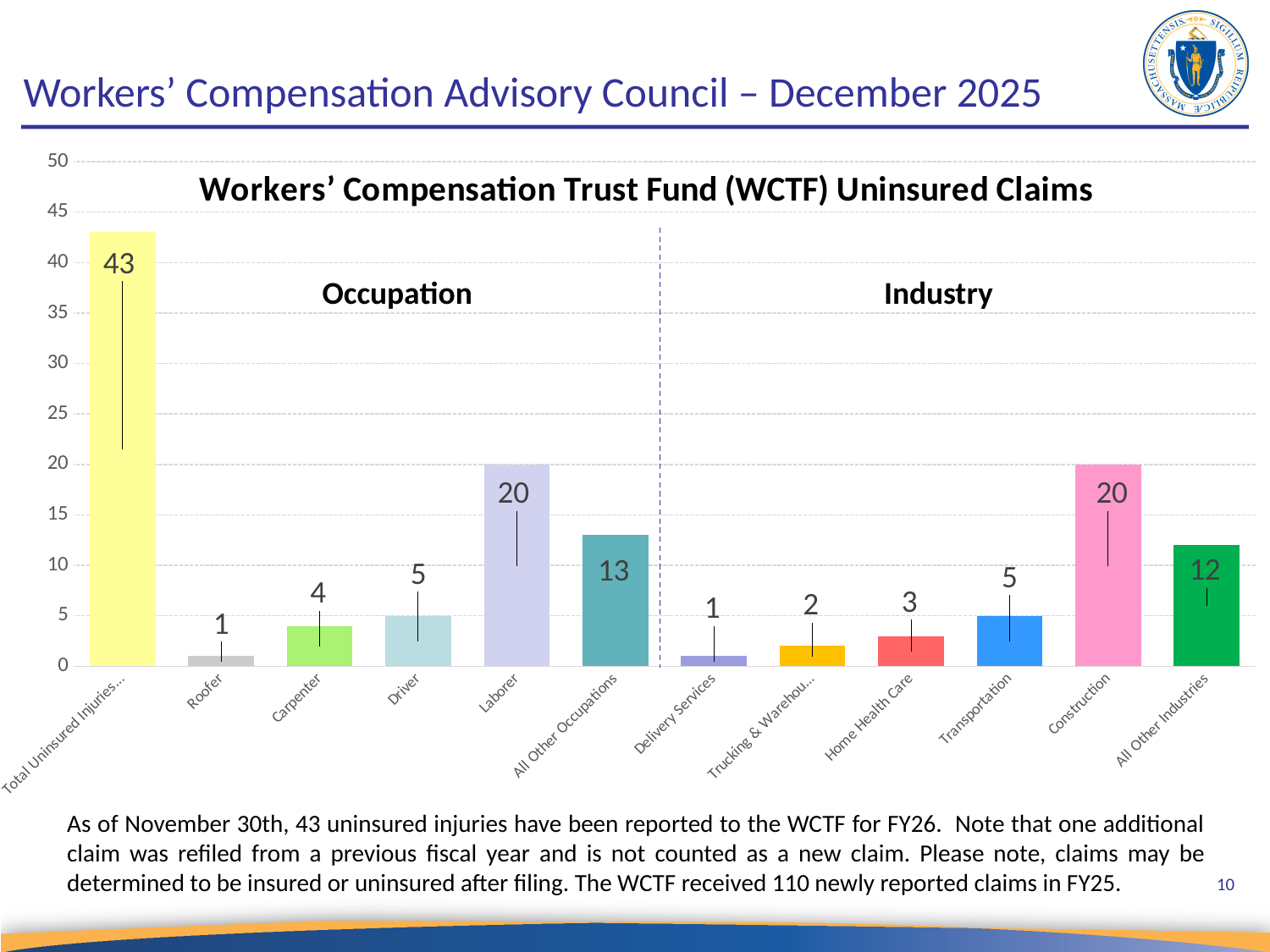
What kind of chart is shown on the slide? bar chart Which is larger, the value for Carpenter or the value for Driver? Driver How many bars are plotted in the chart? 12 What is the difference between the values for Laborer and All Other Occupations? 7 What is the value for Home Health Care? 3 What is the value for Laborer? 20 Which category has the highest value among the Occupation bars, excluding the total bar? Laborer What is the value for All Other Industries? 12 Which category has the lowest value among the Industry bars? Delivery Services What is the value for Construction? 20 What are the two group headings shown above the bars in the chart? Occupation and Industry Is the value for Construction greater or less than 15? greater